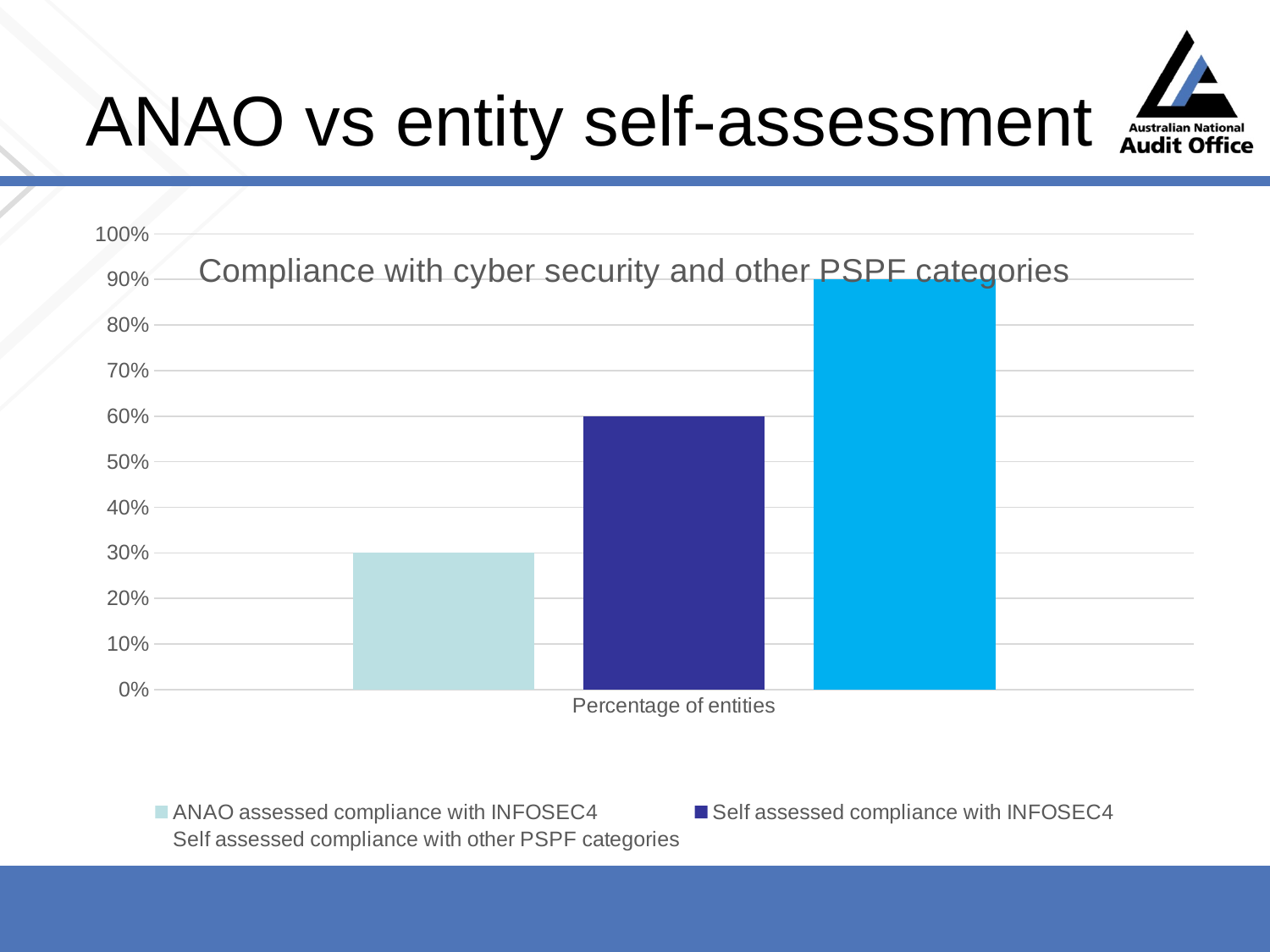
Which series has the lowest value? ANAO assessed compliance with INFOSEC4 Which series has the highest value? Self assessed compliance with other PSPF categories What is the difference between Self assessed compliance with other PSPF categories and Self assessed compliance with INFOSEC4? 30% What is the label on the x axis under the bars? Percentage of entities What is the difference between Self assessed compliance with INFOSEC4 and ANAO assessed compliance with INFOSEC4? 30% How many series does the legend list? 3 What is the value for ANAO assessed compliance with INFOSEC4? 30% Which is larger: ANAO assessed compliance with INFOSEC4 or Self assessed compliance with INFOSEC4? Self assessed compliance with INFOSEC4 What is the chart title? Compliance with cyber security and other PSPF categories What is the value for Self assessed compliance with other PSPF categories? 90% What kind of chart is shown on the slide? bar chart What is the value for Self assessed compliance with INFOSEC4? 60%